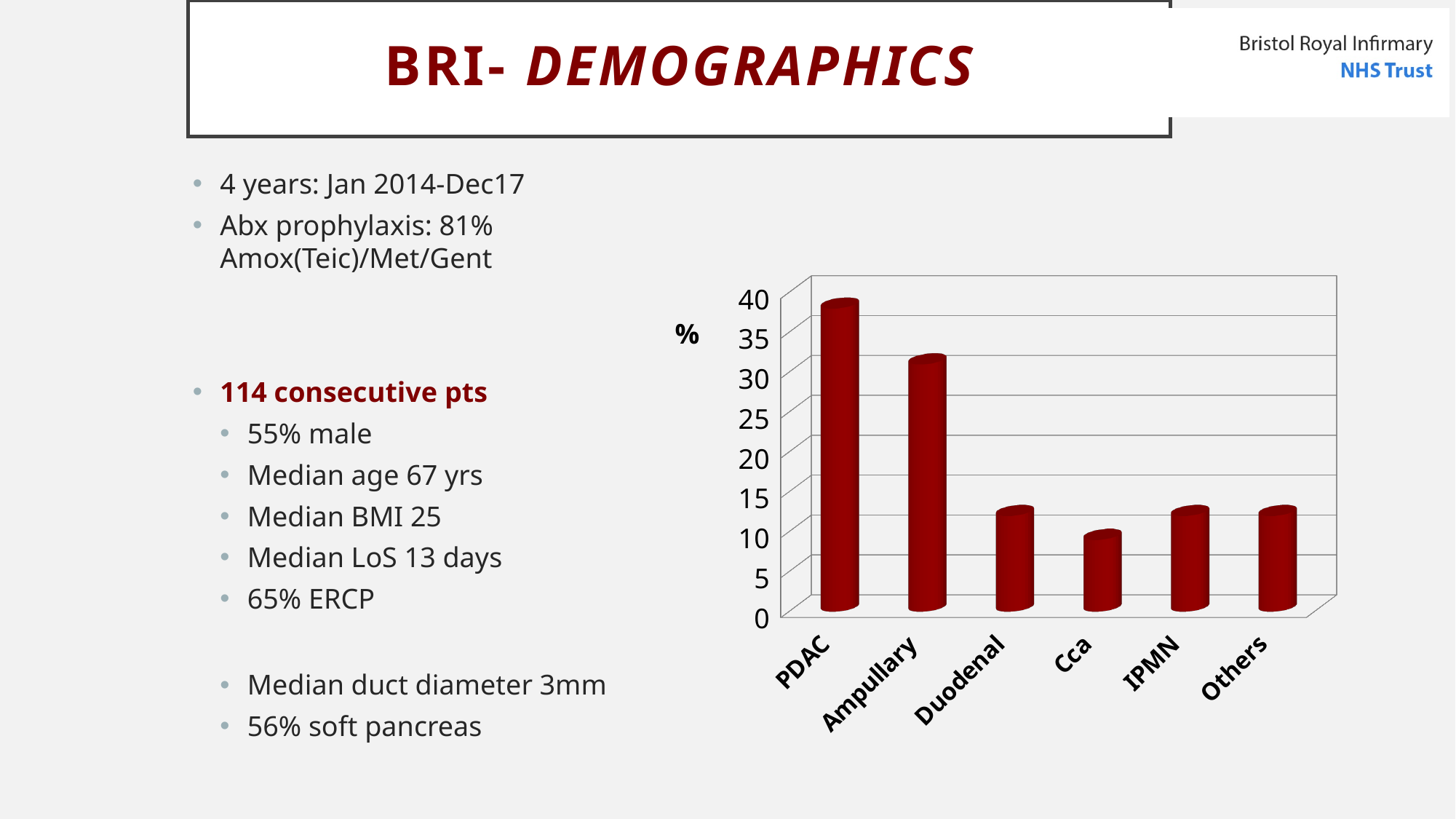
What kind of chart is shown on the slide? bar chart What label is shown on the vertical axis of the chart? % Which category has the lowest value in the chart? Cca What colour are the bars in the chart? dark red Is the value for Cca greater or less than 15? less Is the value for PDAC greater or less than 35? greater Is the value for Ampullary greater or less than 35? less Which is larger, the value for PDAC or the value for Ampullary? PDAC Which category has the highest value in the chart? PDAC How many categories are shown on the x axis of the chart? 6 Which is larger, the value for Duodenal or the value for Cca? Duodenal